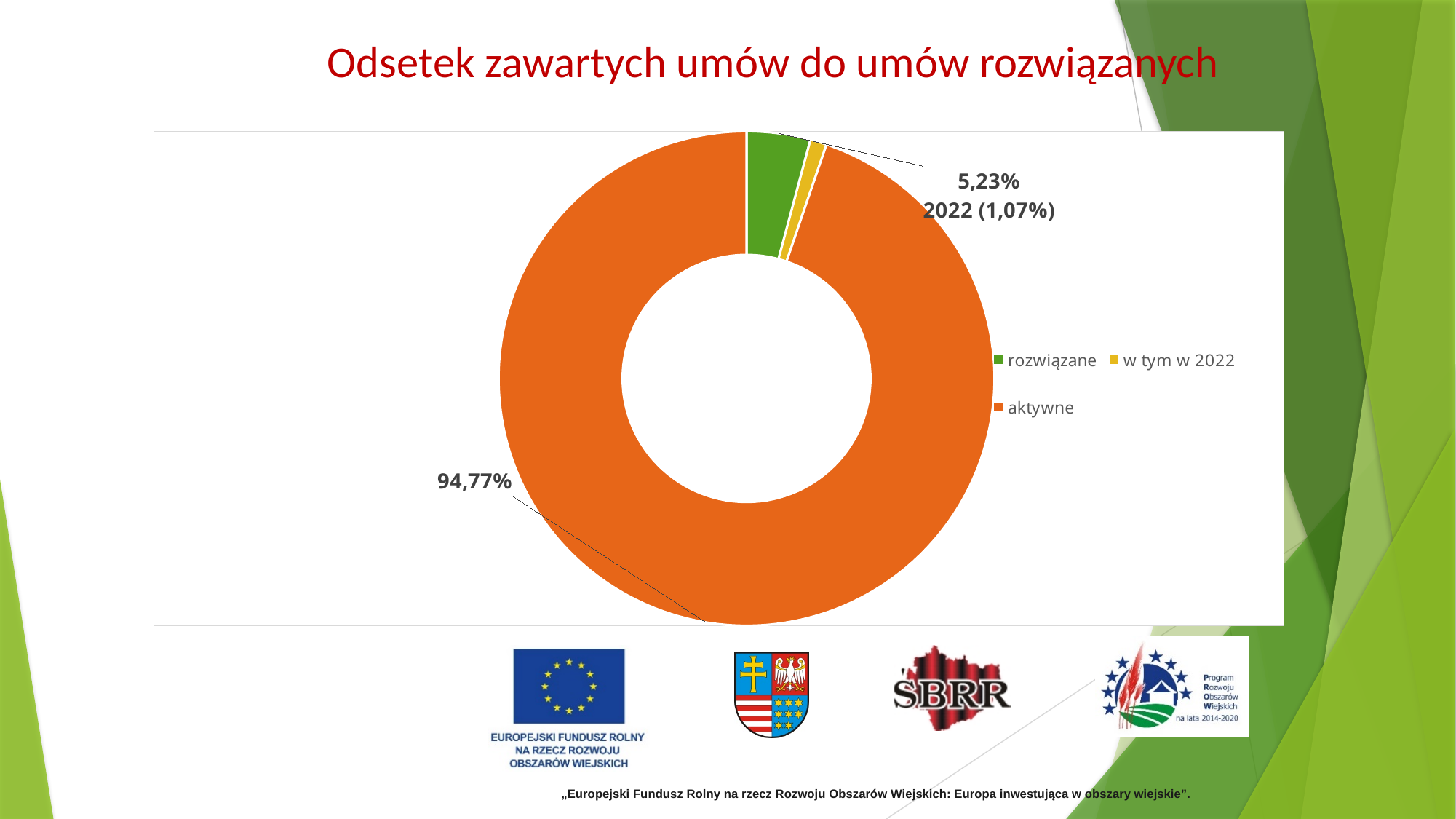
What is the difference between the 'aktywne' share and the 'rozwiązane' share? 89,54% What percentage is shown for the 'rozwiązane' slice? 5,23% What percentage is shown for the 'w tym w 2022' slice? 1,07% What percentage is shown for the 'aktywne' slice? 94,77% Is the share for 'aktywne' greater or less than 90%? greater How many entries does the chart legend list? 3 Which slice is the largest in the chart? aktywne What is the title of the chart? Odsetek zawartych umów do umów rozwiązanych Which is larger, the 'rozwiązane' slice or the 'w tym w 2022' slice? rozwiązane What kind of chart is shown on the slide? doughnut (pie) chart Which slice is the smallest in the chart? w tym w 2022 What colour is used for the 'aktywne' slice? orange